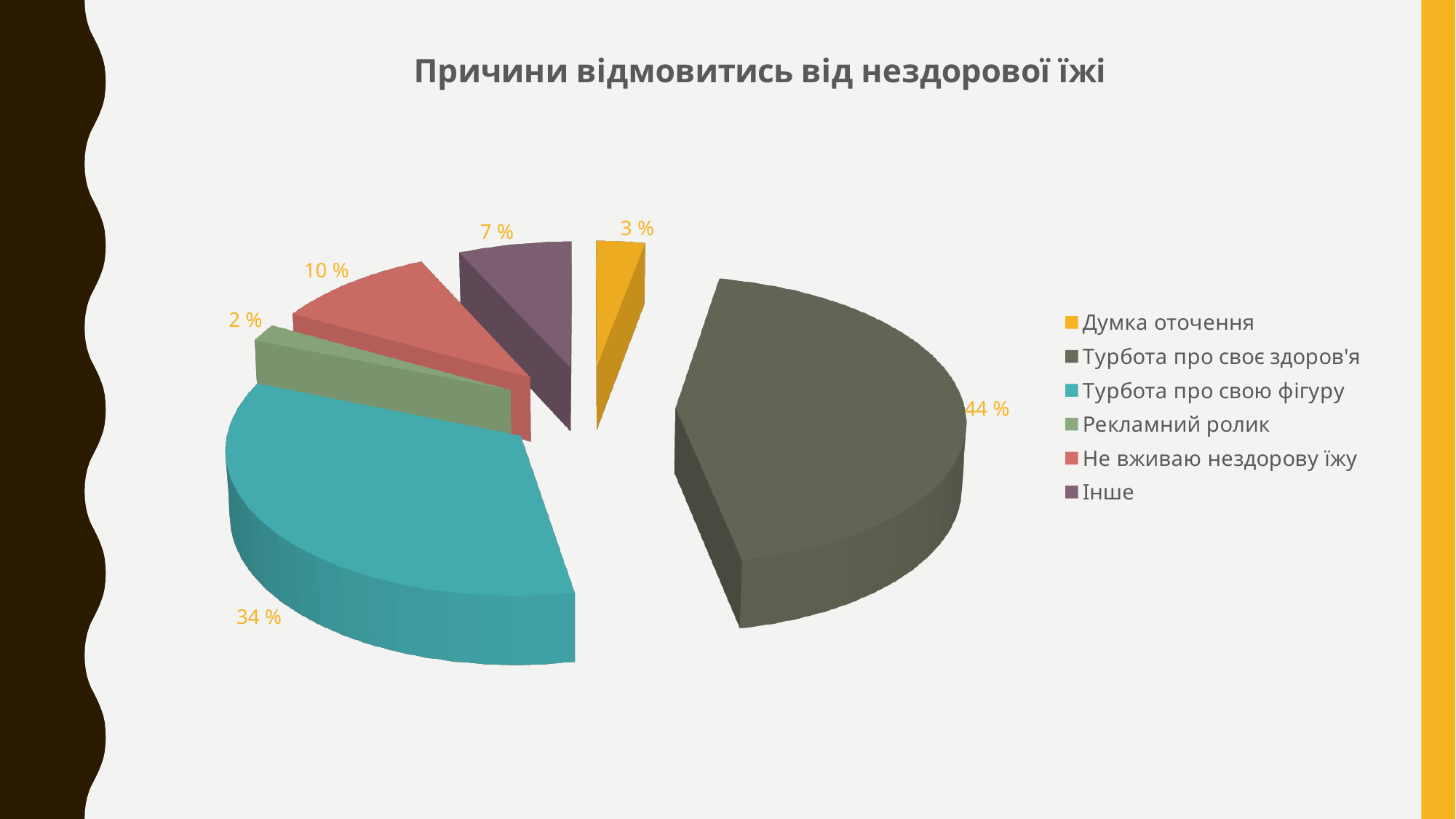
What value is shown for 'Інше'? 7 % Which is larger, the share for 'Інше' or the share for 'Думка оточення'? Інше What is the difference between the shares for 'Турбота про своє здоров'я' and 'Турбота про свою фігуру'? 10 % What is the title of the chart? Причини відмовитись від нездорової їжі What share of the pie is labelled for 'Турбота про свою фігуру'? 34 % How many slices does the pie chart have? 6 Which category has the smallest share of the pie? Рекламний ролик What kind of chart is shown on the slide? Pie chart What share of the pie is labelled for 'Турбота про своє здоров'я'? 44 % Which category has the largest share of the pie? Турбота про своє здоров'я What value is shown for 'Не вживаю нездорову їжу'? 10 % What value is shown for 'Думка оточення'? 3 %